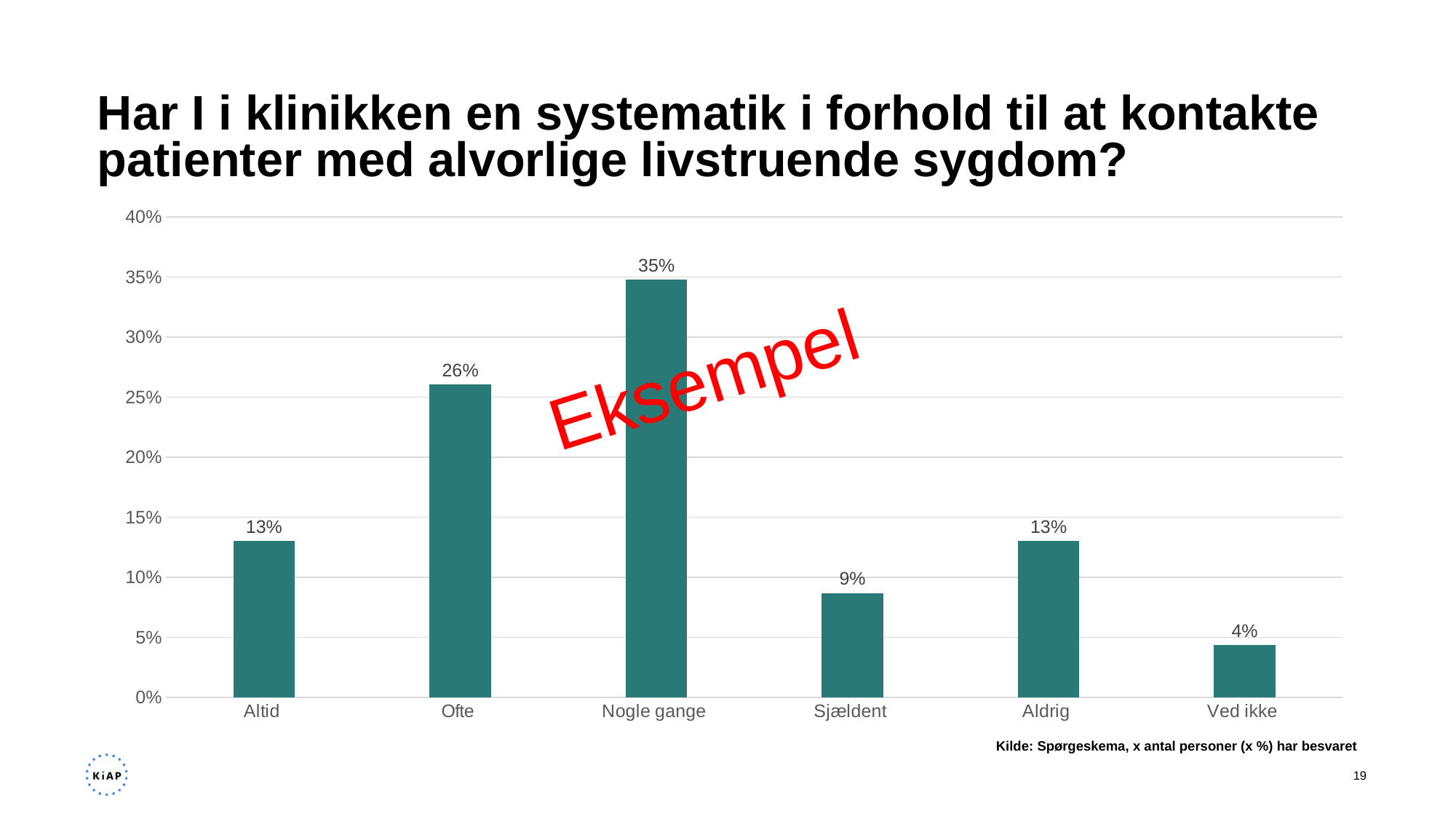
What is the difference between the values for Nogle gange and Ofte? 9% Which is larger, the value for Ofte or the value for Aldrig? Ofte What is the value for Sjældent? 9% Which category has the lowest value? Ved ikke What is the value for Nogle gange? 35% What is the value for Altid? 13% How many categories are shown on the x axis? 6 Is the value for Ofte greater or less than 25%? greater What is the value for Ofte? 26% What is the value for Ved ikke? 4% What kind of chart is shown on the slide? Bar chart Which category has the highest value? Nogle gange